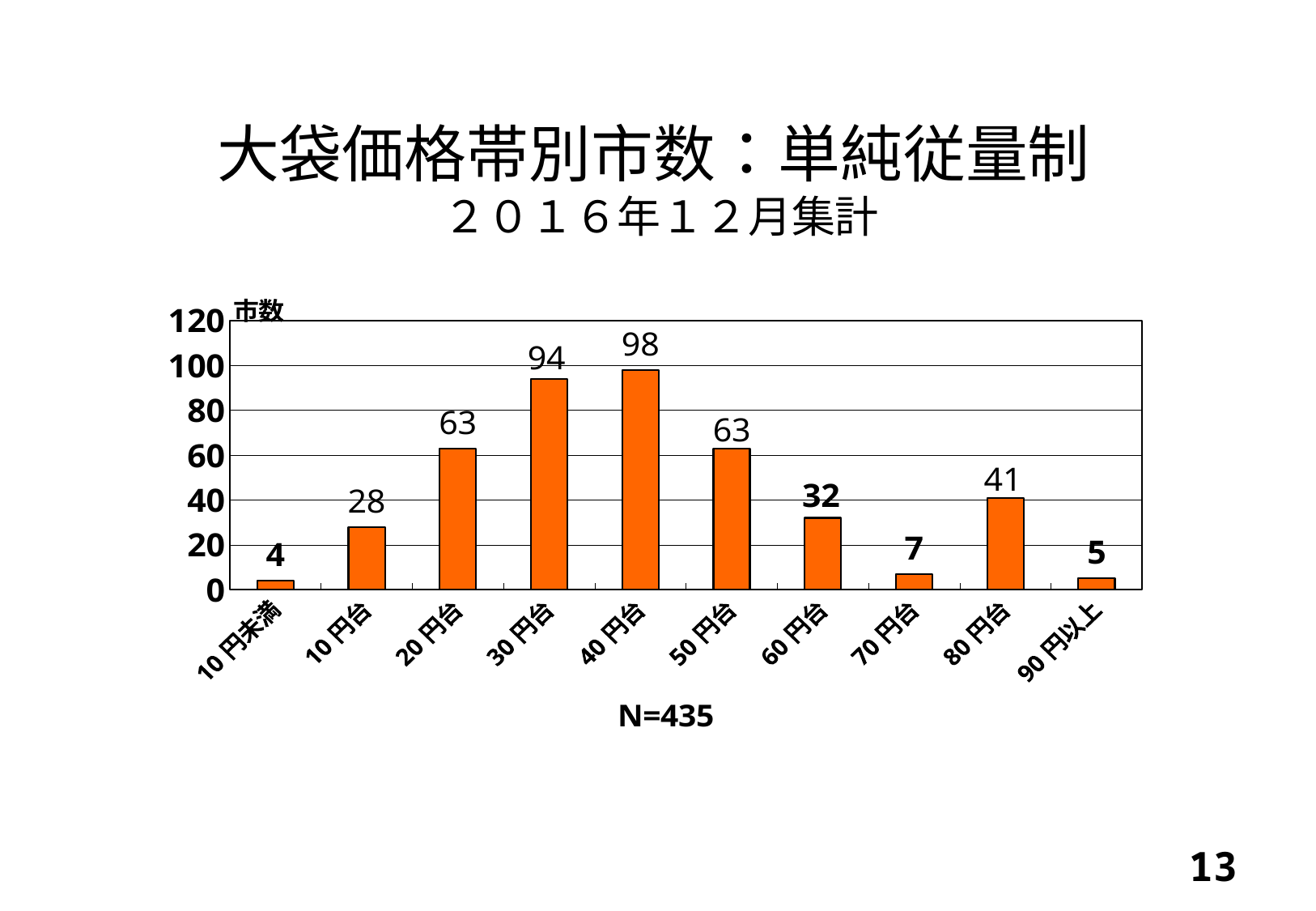
What is the difference between the values for 40円台 and 30円台? 4 What is the value for 80円台? 41 What is the value for 40円台? 98 What is the sample size (N) shown below the chart? N=435 Which is larger, the value for 10円台 or the value for 80円台? 80円台 Which price band has the lowest number of cities? 10円未満 How many price band categories are shown on the x axis? 10 What is the difference between the values for 50円台 and 60円台? 31 What is the value for 10円未満? 4 Do the values rise or fall from 40円台 to 70円台? Fall Which price band has the highest number of cities? 40円台 What kind of chart is shown on the slide? Bar chart